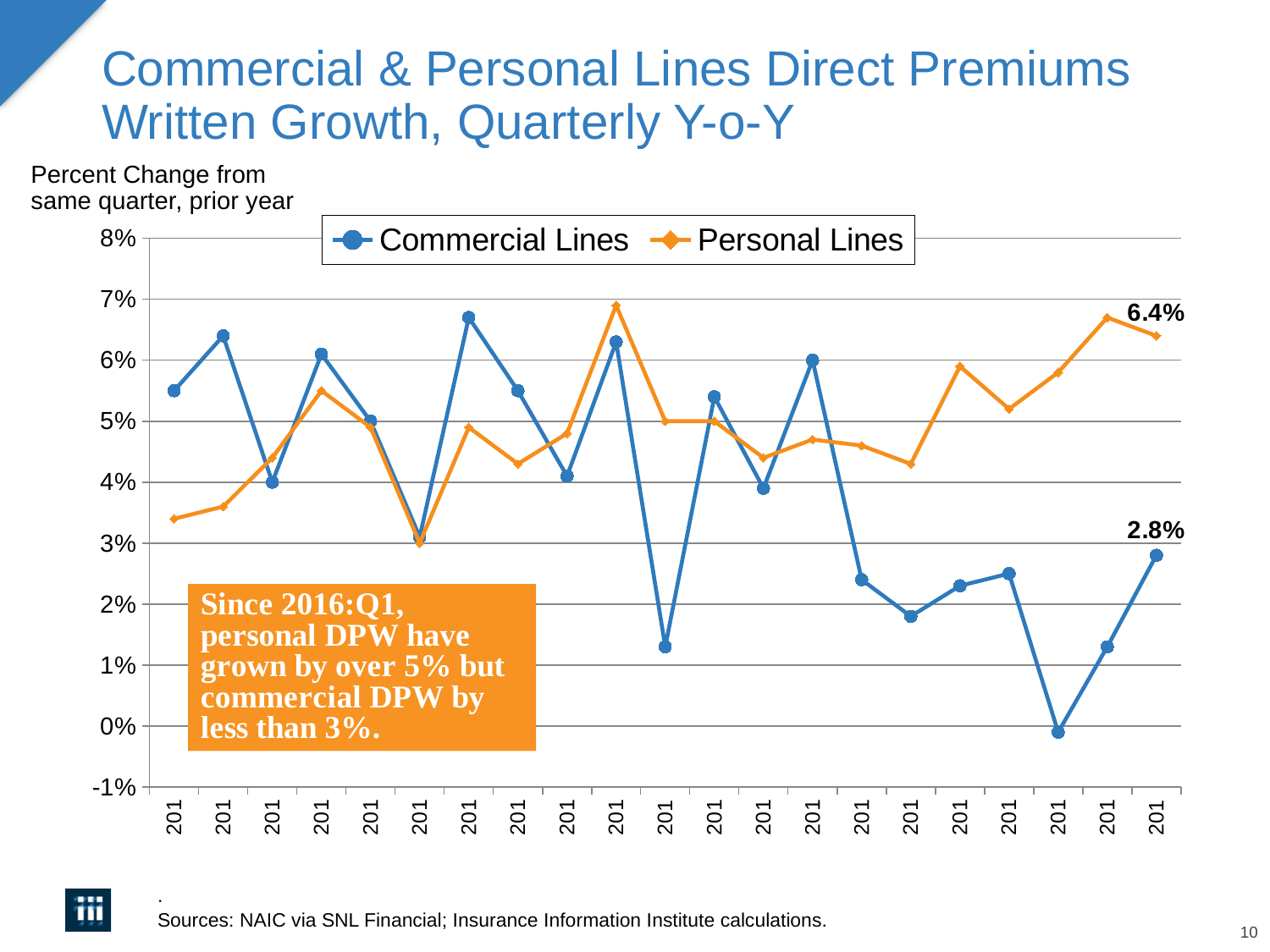
Is the highest Personal Lines value on the chart greater or less than 6%? greater Which series reaches the lowest point anywhere on the chart? Commercial Lines Which colour is used for the Commercial Lines series? Blue What is the labelled value of the final Personal Lines data point? 6.4% What is the labelled value of the final Commercial Lines data point? 2.8% How many data points are plotted for each series? 21 What is the difference between the final labelled Personal Lines value and the final labelled Commercial Lines value? 3.6 percentage points At the final data point, which series has the higher value, Commercial Lines or Personal Lines? Personal Lines What kind of chart is shown on the slide? Line chart Does the Personal Lines series end higher or lower than it starts? Higher How many series does the legend list? 2 Is the lowest Commercial Lines value on the chart greater or less than 1%? less